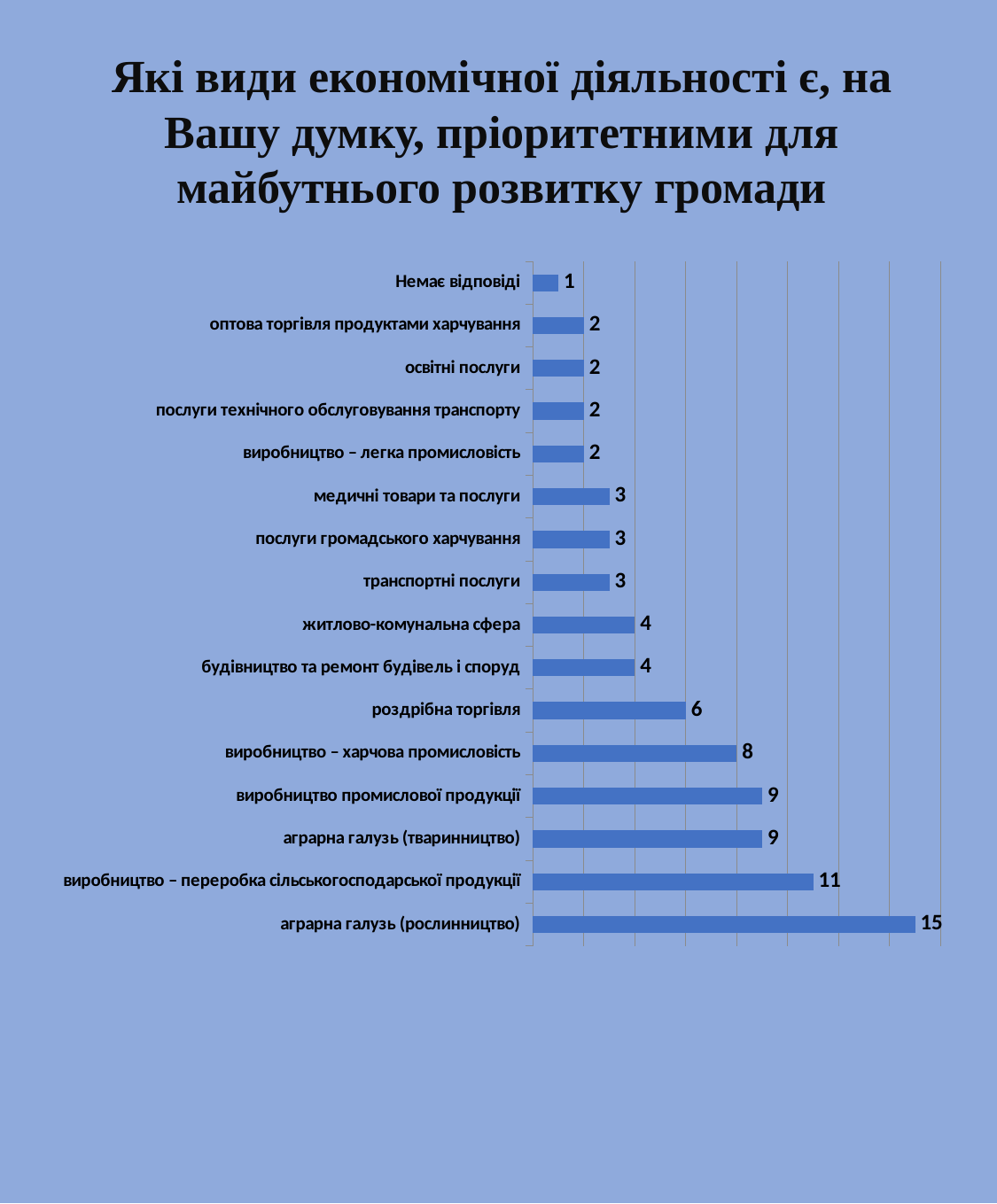
Which category has the highest value? аграрна галузь (рослинництво) What is the value for житлово-комунальна сфера? 4 What kind of chart is shown on the slide? bar chart What is the value for аграрна галузь (рослинництво)? 15 Which category has the lowest value? Немає відповіді How many categories are shown in the chart? 16 What is the difference between the values for виробництво – харчова промисловість and роздрібна торгівля? 2 What is the value for медичні товари та послуги? 3 What is the value for виробництво – переробка сільськогосподарської продукції? 11 What is the difference between the values for аграрна галузь (рослинництво) and виробництво – переробка сільськогосподарської продукції? 4 Which is larger, the value for виробництво – харчова промисловість or the value for транспортні послуги? виробництво – харчова промисловість What is the value for роздрібна торгівля? 6